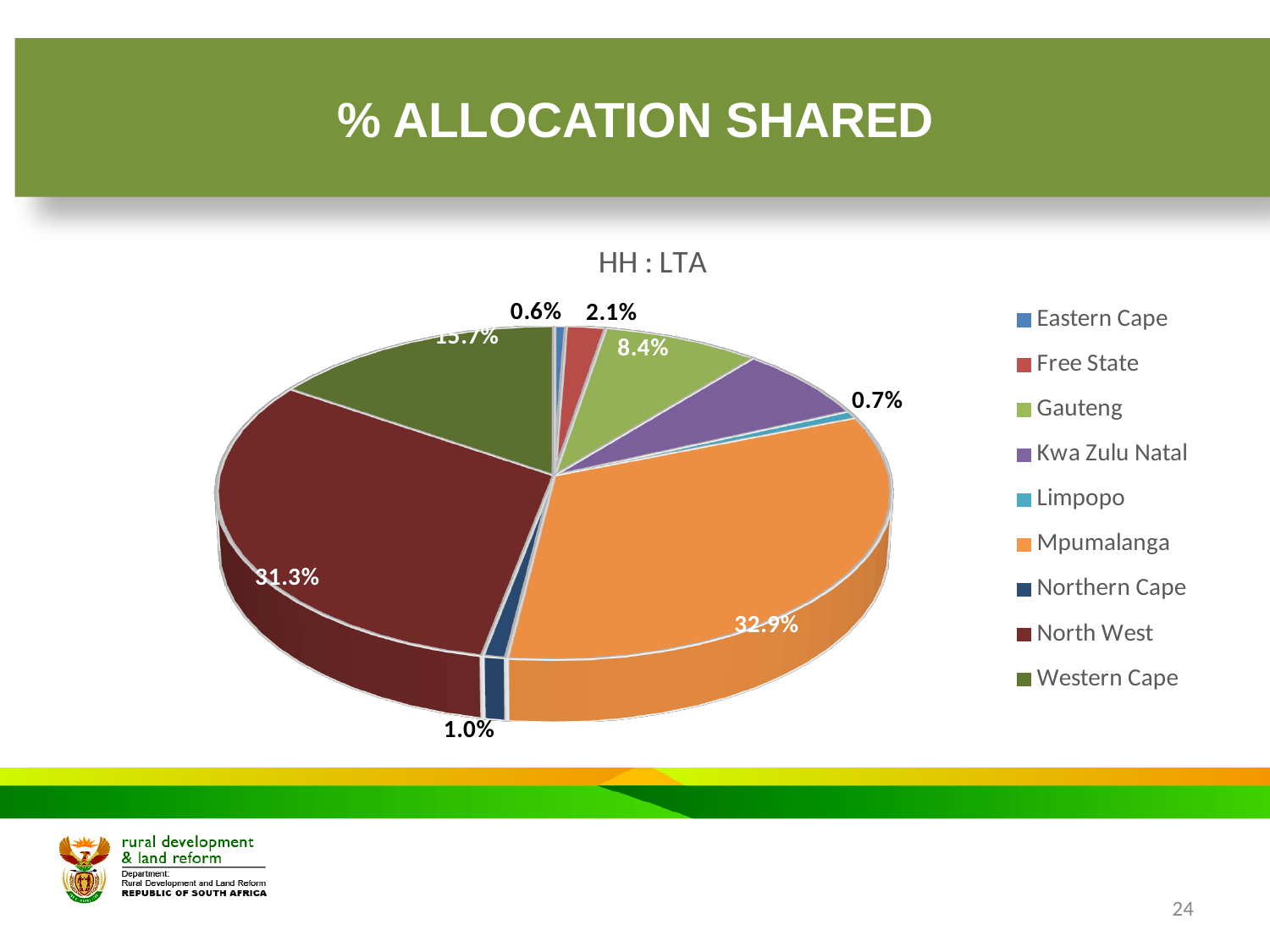
What percentage share is shown for Gauteng? 8.4% What percentage share is shown for Free State? 2.1% Which province has the smallest share of the pie? Eastern Cape What percentage share is shown for Mpumalanga? 32.9% Which province has the largest share of the pie? Mpumalanga What is the title of the pie chart? HH : LTA What percentage share is shown for Limpopo? 0.7% How many provinces (categories) does the legend list? 9 What kind of chart is shown on the slide? pie chart What percentage share is shown for Northern Cape? 1.0% What is the difference between the shares of Mpumalanga and North West? 1.6% What percentage share is shown for North West? 31.3%